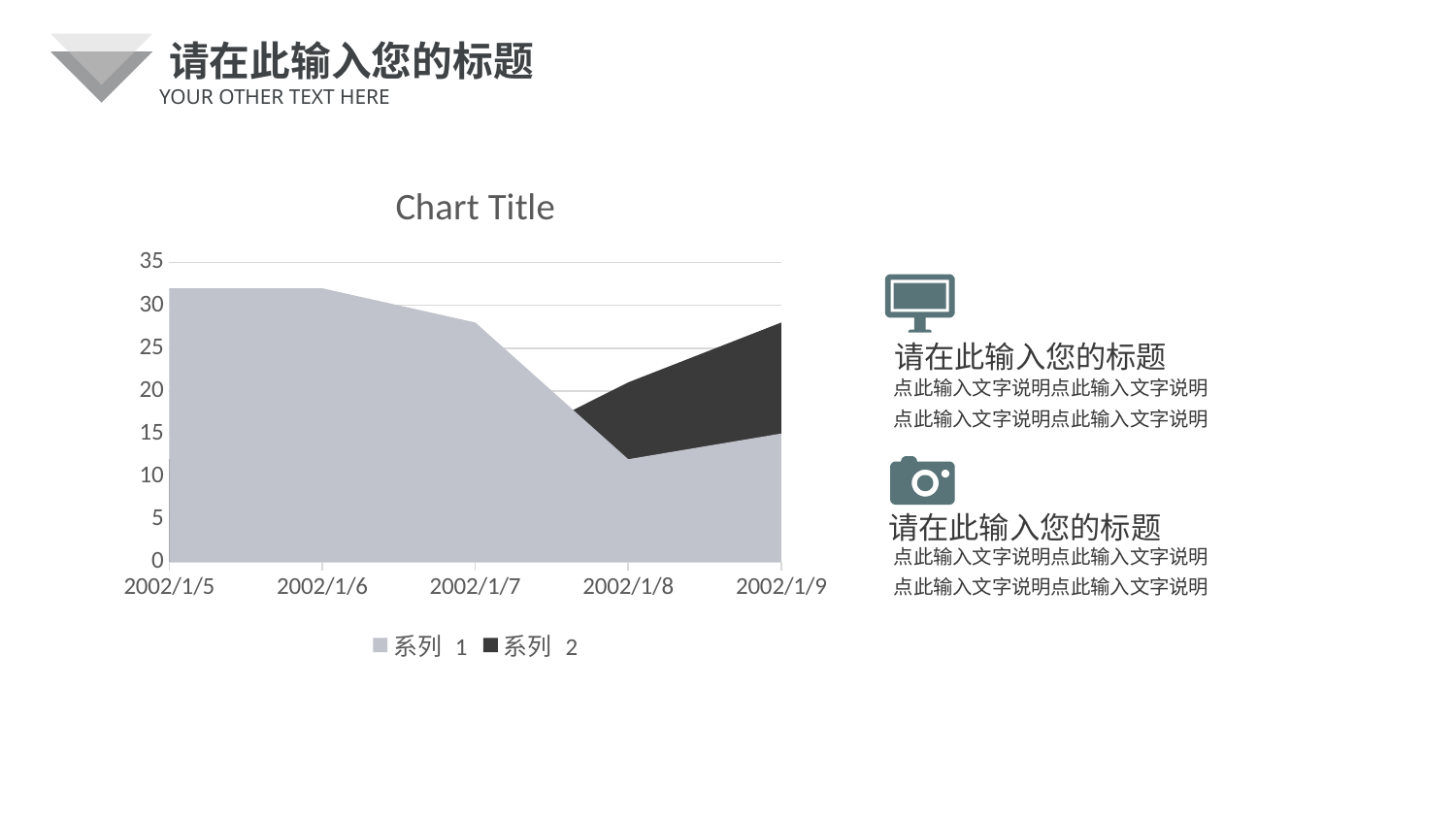
At 2002/1/9, which series has the larger value, 系列 1 or 系列 2? 系列 2 What are the two legend entries of the chart? 系列 1 and 系列 2 What kind of chart is shown on the slide? area chart How many series does the chart legend list? 2 Is the value for 系列 1 at 2002/1/7 greater or less than 25? greater Is the value for 系列 2 at 2002/1/9 greater or less than 25? greater What is the title of the chart? Chart Title Is the value for 系列 1 at 2002/1/8 greater or less than 15? less Does the value of 系列 1 rise or fall from 2002/1/6 to 2002/1/8? fall How many dates are shown on the x axis of the chart? 5 At which date does 系列 1 reach its lowest value? 2002/1/8